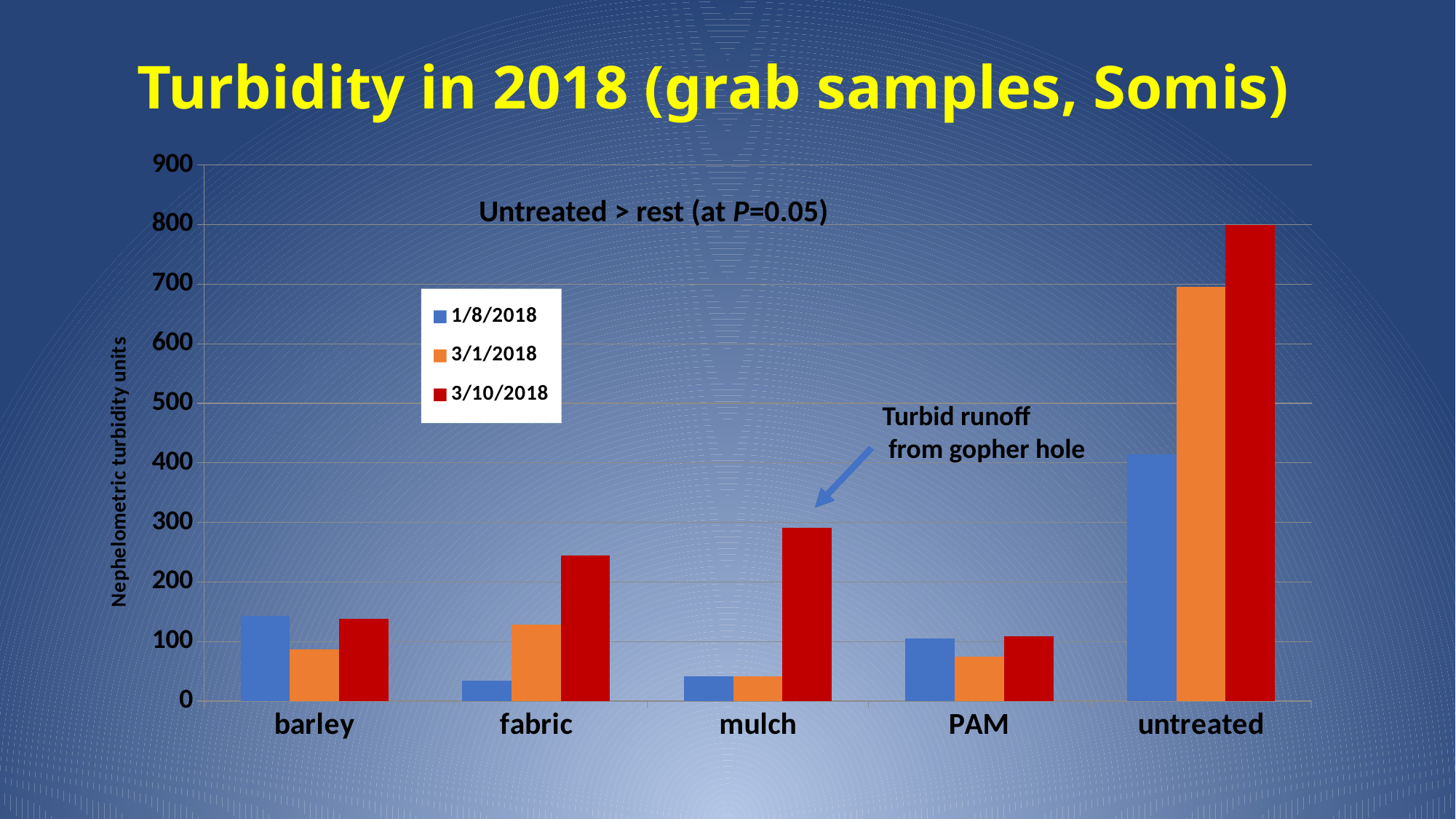
Which category has the highest value for the 3/10/2018 series? untreated Is the value for mulch on 3/10/2018 greater or less than 200? greater Is the value for untreated on 3/1/2018 greater or less than 600? greater For the untreated category, which series has the larger value: 1/8/2018 or 3/1/2018? 3/1/2018 What kind of chart is shown on the slide? bar chart Is the value for barley on 1/8/2018 greater or less than 200? less What is the label on the y axis? Nephelometric turbidity units What is the title of the slide's chart? Turbidity in 2018 (grab samples, Somis) How many treatment categories are shown on the x axis? 5 How many series does the legend list? 3 Which category has the lowest value for the 3/1/2018 series? mulch For the 3/10/2018 series, which is larger: fabric or barley? fabric